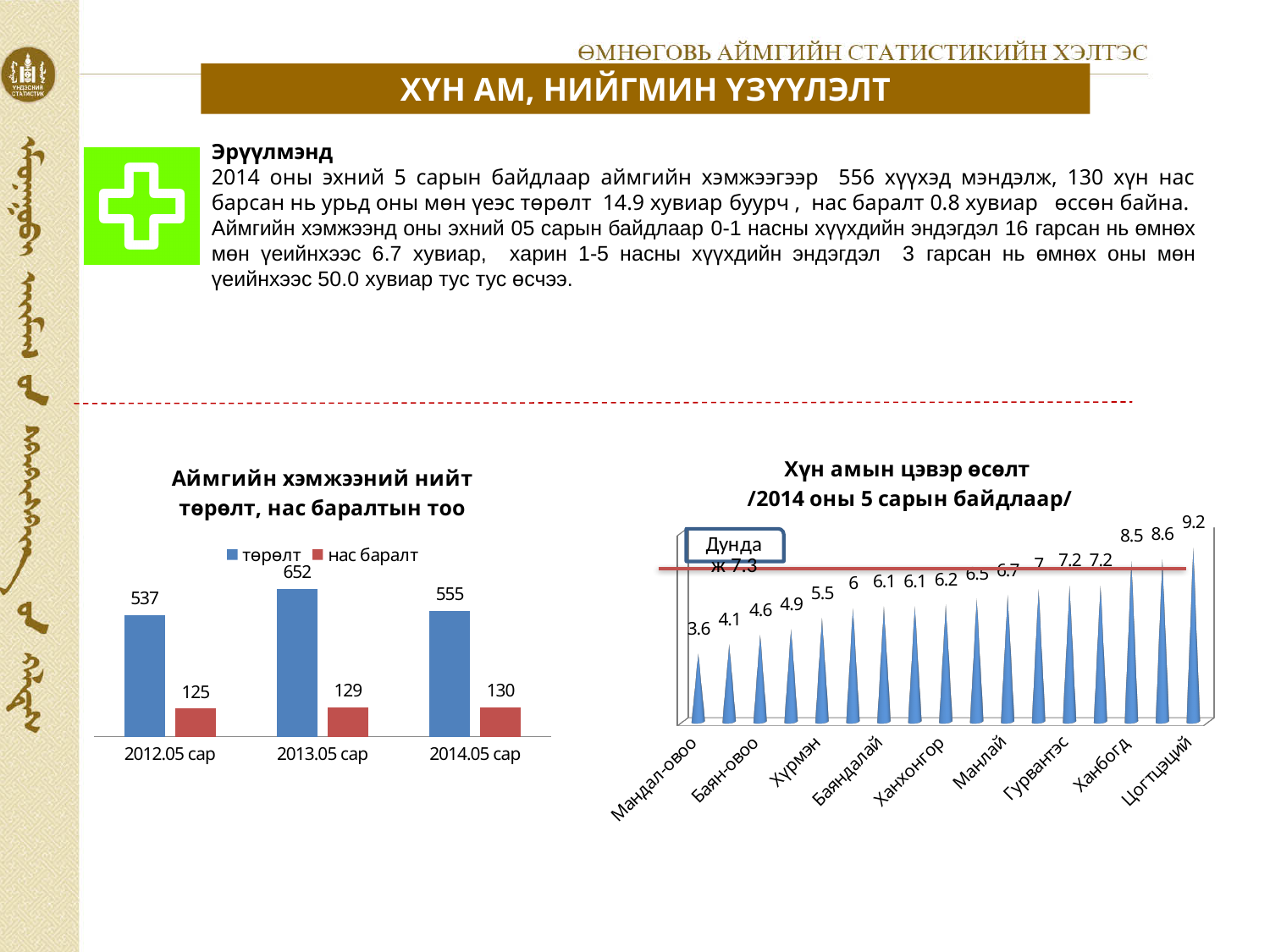
In the chart 'Аймгийн хэмжээний нийт төрөлт, нас баралтын тоо', does the нас баралт series rise or fall from 2012.05 сар to 2014.05 сар? rise In the chart 'Хүн амын цэвэр өсөлт', how many categories are plotted? 17 In the chart 'Хүн амын цэвэр өсөлт', what is the value for Мандал-овоо? 3.6 In the chart 'Хүн амын цэвэр өсөлт', which category has the highest value? Цогтцэций In the chart 'Аймгийн хэмжээний нийт төрөлт, нас баралтын тоо', what is the value of нас баралт for 2014.05 сар? 130 In the chart 'Хүн амын цэвэр өсөлт', what average value (Дундаж) is marked by the red line? 7.3 In the chart 'Аймгийн хэмжээний нийт төрөлт, нас баралтын тоо', what is the difference between төрөлт and нас баралт for 2014.05 сар? 425 In the chart 'Аймгийн хэмжээний нийт төрөлт, нас баралтын тоо', what is the value of төрөлт for 2013.05 сар? 652 In the chart 'Аймгийн хэмжээний нийт төрөлт, нас баралтын тоо', how many series does the legend list? 2 In the chart 'Аймгийн хэмжээний нийт төрөлт, нас баралтын тоо', which period has the lowest нас баралт value? 2012.05 сар In the chart 'Аймгийн хэмжээний нийт төрөлт, нас баралтын тоо', which period has the highest төрөлт value? 2013.05 сар What type of chart is 'Аймгийн хэмжээний нийт төрөлт, нас баралтын тоо'? bar chart